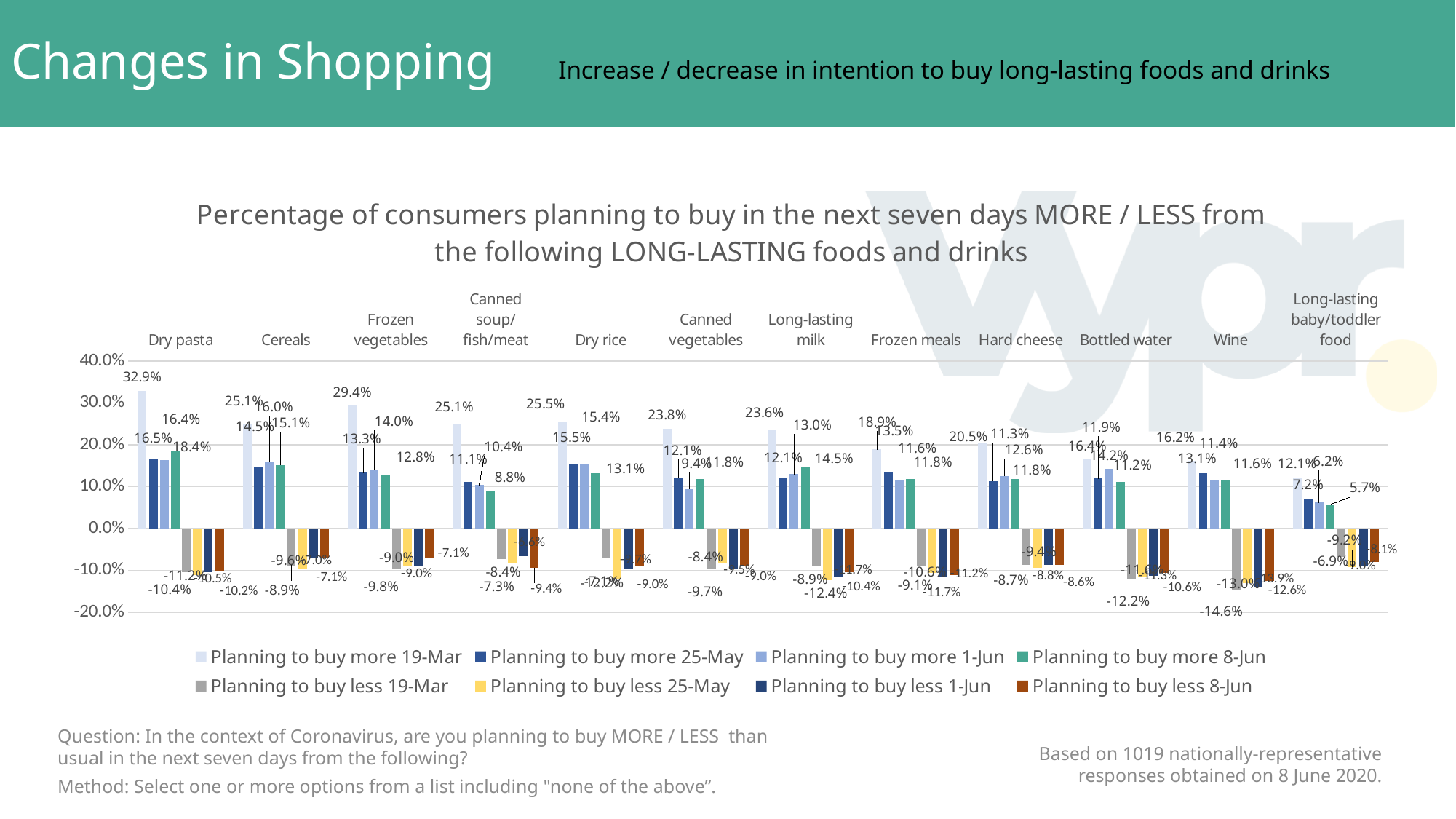
What kind of chart is shown on the slide? Bar chart How many series does the chart's legend list? 8 Is the 'Planning to buy more 19-Mar' value for Canned vegetables greater or less than 20.0%? greater What is the value for Long-lasting milk in the 'Planning to buy more 8-Jun' series? 14.5% How many food and drink categories are shown on the x axis of the chart? 12 Which category has the highest value in the 'Planning to buy more 19-Mar' series? Dry pasta What is the value for Frozen vegetables in the 'Planning to buy more 19-Mar' series? 29.4% What is the value for Dry pasta in the 'Planning to buy more 19-Mar' series? 32.9% What is the difference between the 'Planning to buy more 19-Mar' value (32.9%) and the 'Planning to buy more 8-Jun' value (18.4%) for Dry pasta? 14.5 percentage points What is the value for Wine in the 'Planning to buy less 19-Mar' series? -14.6% In the 'Planning to buy more 19-Mar' series, which is larger: Cereals or Frozen vegetables? Frozen vegetables Which category has the lowest value in the 'Planning to buy more 19-Mar' series? Long-lasting baby/toddler food